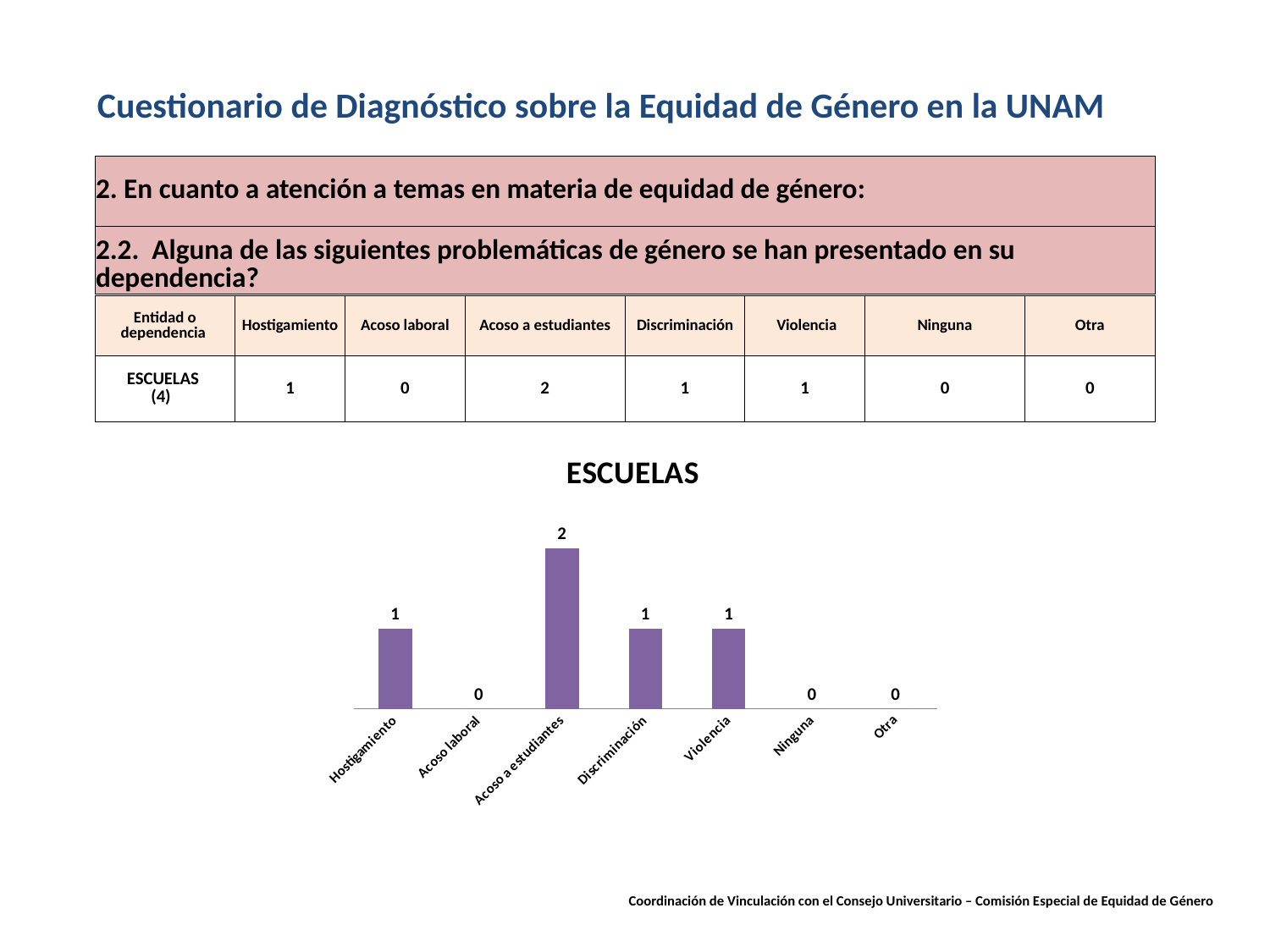
What is the total of all the values shown in the ESCUELAS chart? 5 Which category has the highest value in the ESCUELAS chart? Acoso a estudiantes What is the value for Violencia in the ESCUELAS chart? 1 How many categories in the ESCUELAS chart have a value of 0? 3 What kind of chart is the ESCUELAS chart? Bar chart What is the title of the chart on the slide? ESCUELAS What is the difference between the values for Acoso a estudiantes and Discriminación in the ESCUELAS chart? 1 What is the value for Hostigamiento in the ESCUELAS chart? 1 What is the value for Acoso a estudiantes in the ESCUELAS chart? 2 How many categories are shown on the x axis of the ESCUELAS chart? 7 Which is larger in the ESCUELAS chart, the value for Acoso a estudiantes or the value for Violencia? Acoso a estudiantes What is the value for Acoso laboral in the ESCUELAS chart? 0